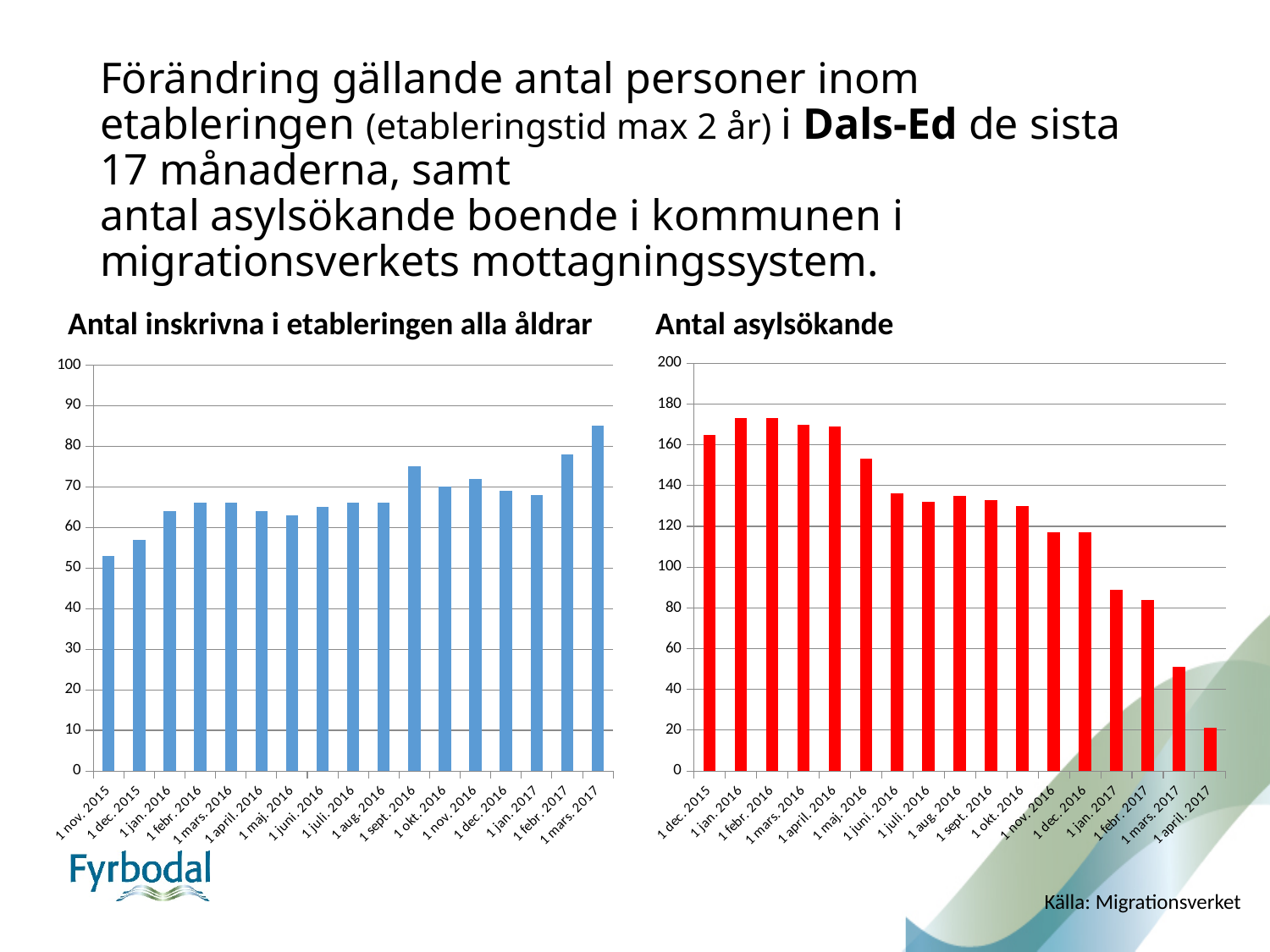
In the 'Antal asylsökande' chart, do the values generally rise or fall from left to right? fall What kind of chart is the 'Antal asylsökande' chart? bar chart In the 'Antal inskrivna i etableringen alla åldrar' chart, which month has the lowest value? 1 nov. 2015 In the 'Antal asylsökande' chart, is the value for 1 dec. 2015 greater or less than 140? greater In the 'Antal inskrivna i etableringen alla åldrar' chart, is the value for 1 mars 2017 greater or less than 80? greater In the 'Antal asylsökande' chart, which is larger, the value for 1 maj 2016 or 1 juni 2016? 1 maj 2016 In the 'Antal inskrivna i etableringen alla åldrar' chart, which is larger, the value for 1 jan. 2017 or 1 febr. 2017? 1 febr. 2017 In the 'Antal inskrivna i etableringen alla åldrar' chart, is the value for 1 nov. 2015 greater or less than 60? less How many months are shown on the x axis of the 'Antal asylsökande' chart? 17 In the 'Antal asylsökande' chart, which month has the lowest value? 1 april 2017 In the 'Antal inskrivna i etableringen alla åldrar' chart, which month has the highest value? 1 mars 2017